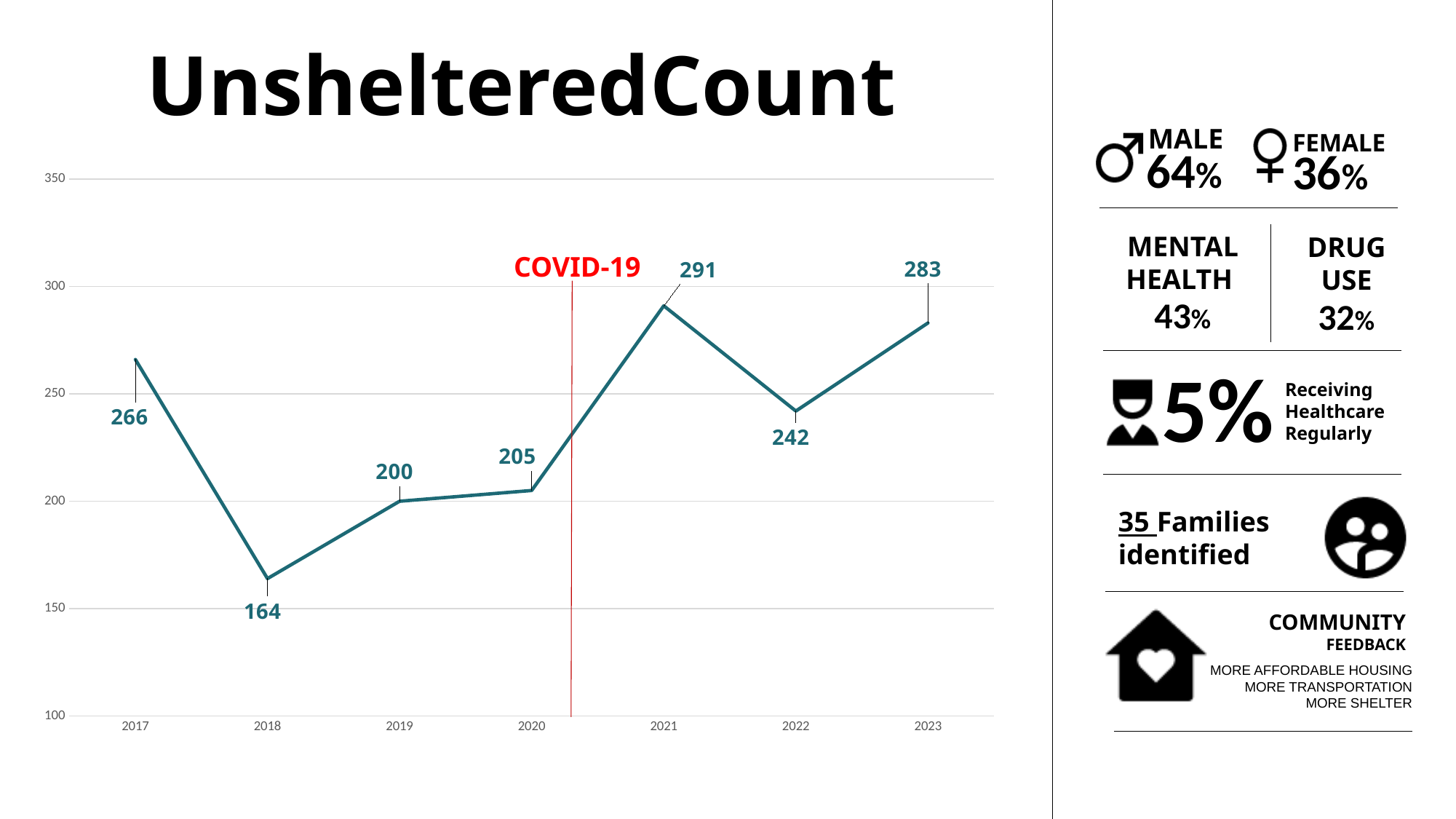
What is the difference between the unsheltered count in 2017 and in 2018? 102 What kind of chart is shown on the slide? line chart What was the unsheltered count in 2023? 283 What was the unsheltered count in 2017? 266 What is the difference between the unsheltered count in 2021 and in 2020? 86 What event does the red vertical line on the chart mark? COVID-19 Which year had the highest unsheltered count? 2021 Which year had the lowest unsheltered count? 2018 Is the unsheltered count for 2019 greater or less than 250? less What was the unsheltered count in 2021? 291 How many years are plotted on the chart? 7 Which year had a higher unsheltered count, 2022 or 2023? 2023